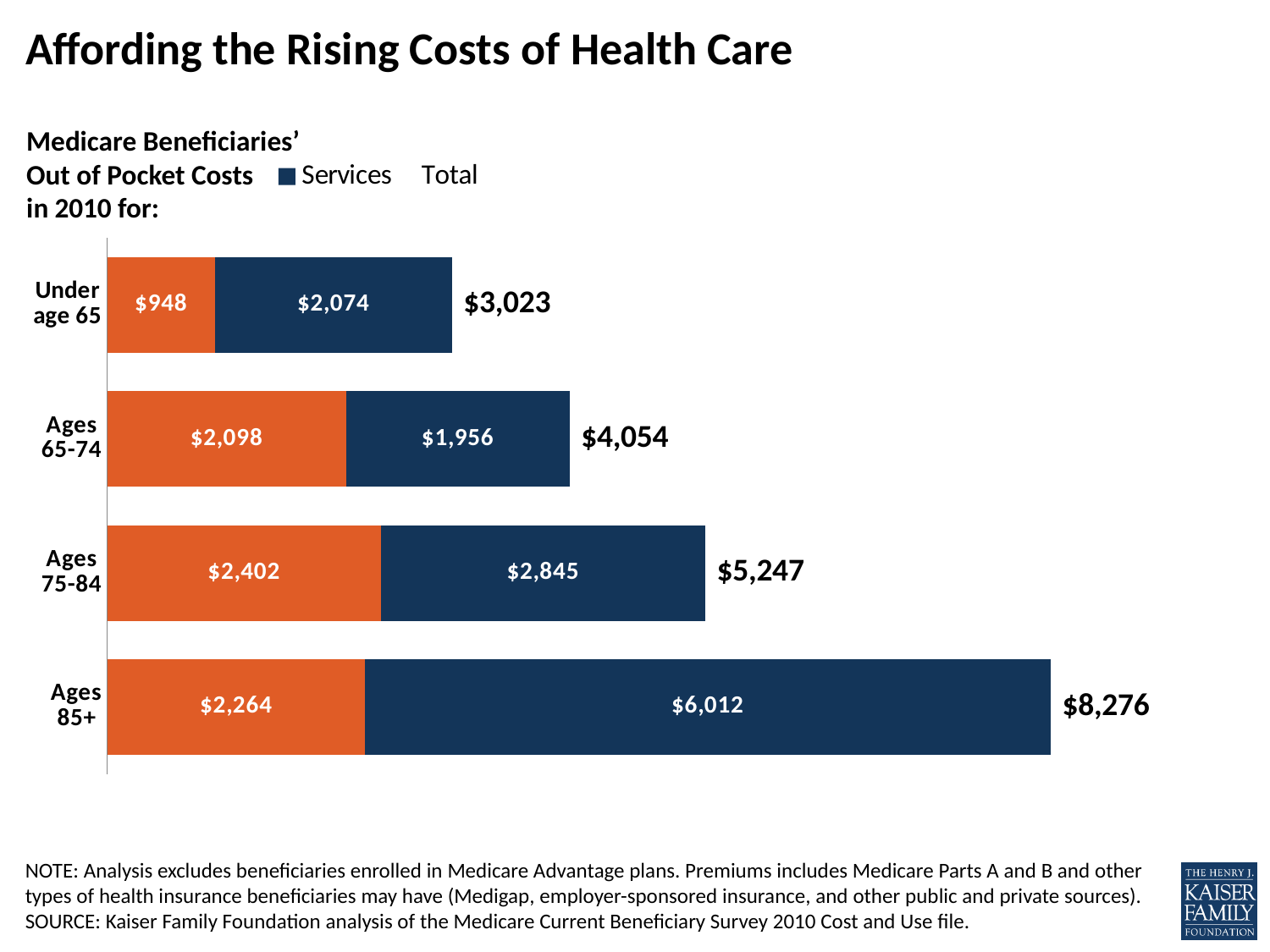
Do the total out-of-pocket costs rise or fall as the age groups get older? Rise What is the total of the stacked bar for Under age 65? $3,023 For Ages 65-74, which is larger: the Services segment or the orange segment? The orange segment How many age groups are shown in the chart? 4 Which age group has the highest total out-of-pocket cost? Ages 85+ Which age group has the lowest total out-of-pocket cost? Under age 65 What is the total out-of-pocket cost shown for Ages 65-74? $4,054 What kind of chart is shown on the slide? Stacked bar chart What is the Services value for Ages 85+? $6,012 What is the title of the slide? Affording the Rising Costs of Health Care What is the difference between the total for Ages 85+ and the total for Ages 75-84? $3,029 What is the value of the orange segment for Ages 75-84? $2,402